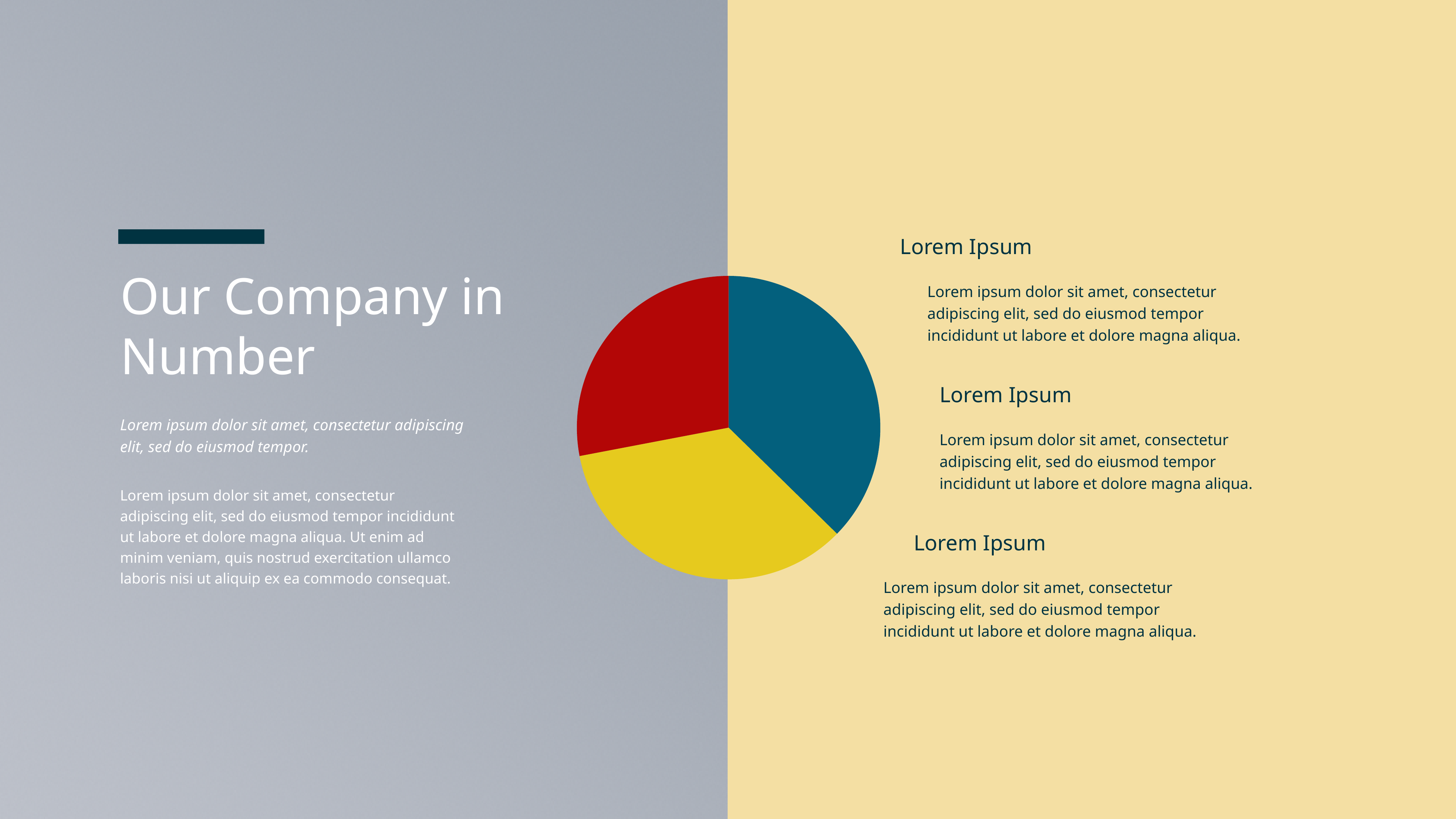
What three colours are used for the slices of the pie chart? blue, red and yellow Which is larger in the pie chart, the blue slice or the red slice? the blue slice How many slices does the pie chart have? 3 What kind of chart is shown on the slide? pie chart What is the title of the slide containing the pie chart? Our Company in Number